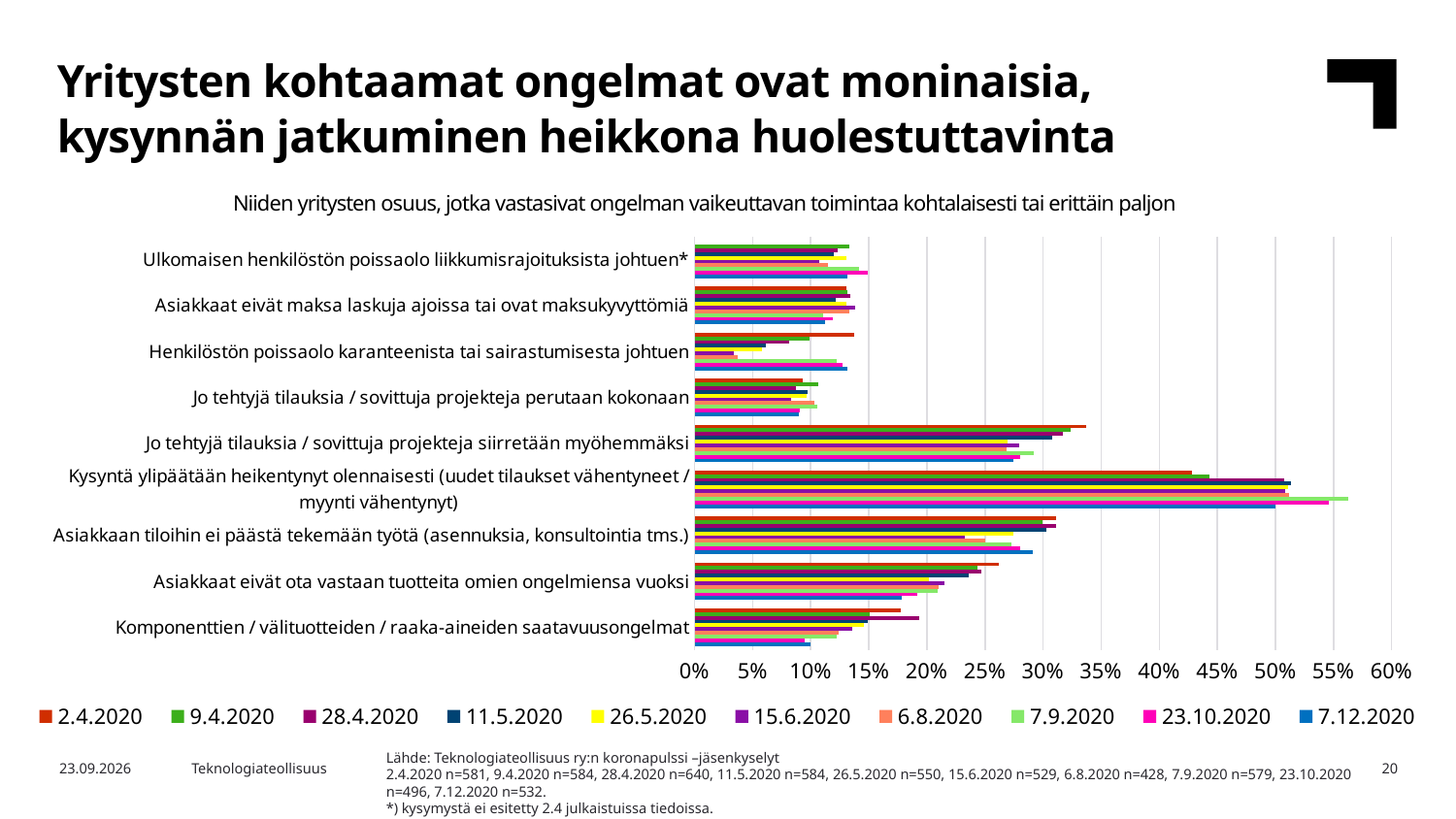
What is the first series listed in the chart legend? 2.4.2020 What kind of chart is shown on the slide? bar chart Is the 2.4.2020 value for 'Komponenttien / välituotteiden / raaka-aineiden saatavuusongelmat' greater or less than 15%? greater Is the 7.9.2020 value for 'Kysyntä ylipäätään heikentynyt olennaisesti' greater or less than 50%? greater How many series does the chart legend list? 10 Is the 2.4.2020 value for 'Jo tehtyjä tilauksia / sovittuja projekteja perutaan kokonaan' greater or less than 10%? less Which category has the highest values across the series in the chart? Kysyntä ylipäätään heikentynyt olennaisesti (uudet tilaukset vähentyneet / myynti vähentynyt) For the 2.4.2020 series, which category has the lowest value? Jo tehtyjä tilauksia / sovittuja projekteja perutaan kokonaan For the 2.4.2020 series, which is larger: the value for 'Kysyntä ylipäätään heikentynyt olennaisesti' or for 'Komponenttien / välituotteiden / raaka-aineiden saatavuusongelmat'? Kysyntä ylipäätään heikentynyt olennaisesti How many categories (problem types) are listed on the vertical axis of the chart? 9 For 'Kysyntä ylipäätään heikentynyt olennaisesti', which is larger: the 2.4.2020 value or the 7.9.2020 value? 7.9.2020